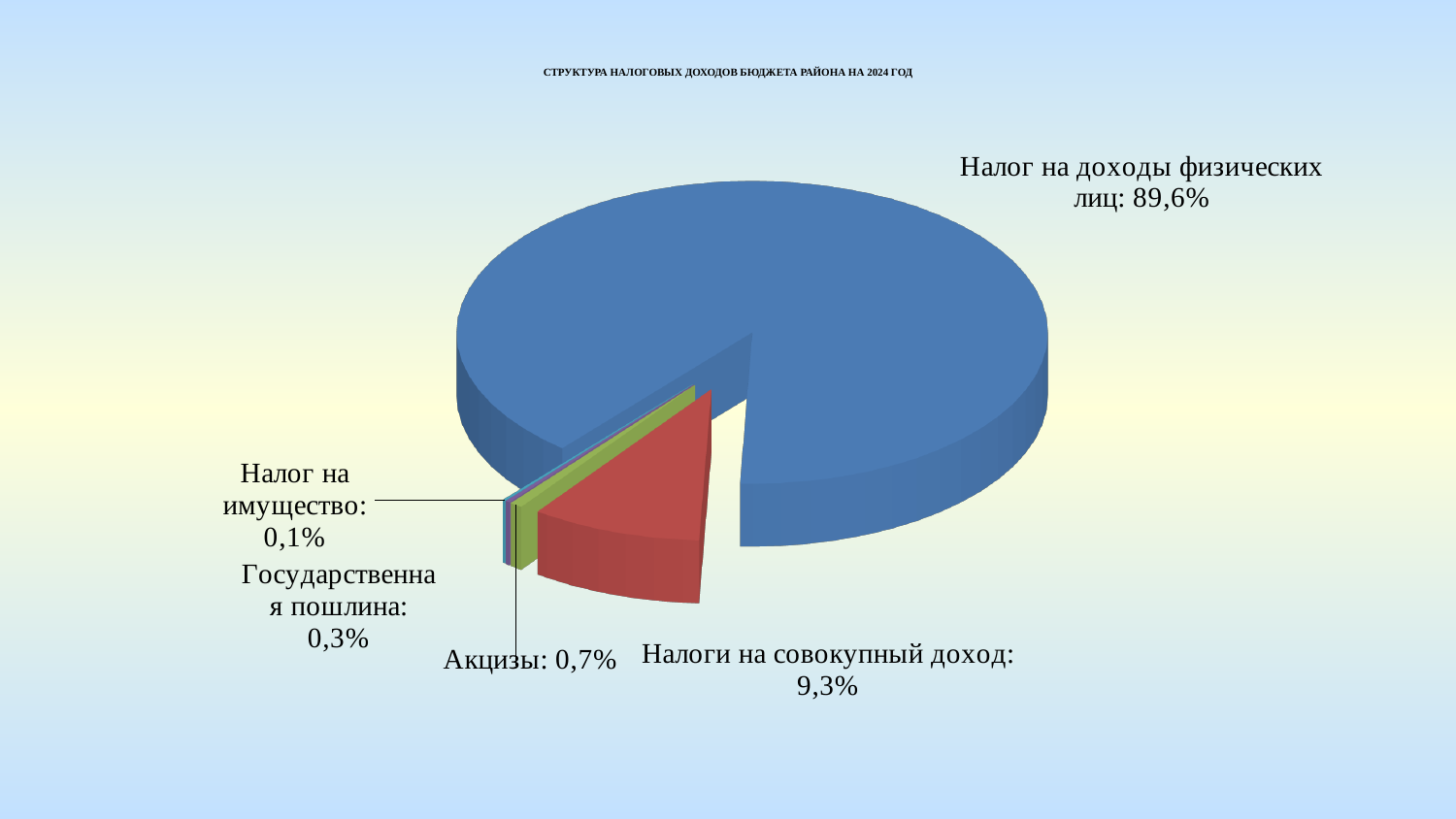
Which is larger: the value for "Акцизы" or the value for "Государственная пошлина"? Акцизы How many categories (slices) does the pie chart have? 5 What share of the pie does "Налог на доходы физических лиц" have? 89,6% What kind of chart is shown on the slide? Pie chart What is the difference between the values for "Налог на доходы физических лиц" and "Налоги на совокупный доход"? 80,3% Which category has the smallest slice of the pie? Налог на имущество What is the value shown for "Государственная пошлина"? 0,3% What is the value shown for "Акцизы"? 0,7% What is the value shown for "Налоги на совокупный доход"? 9,3% What is the value shown for "Налог на имущество"? 0,1% Which category has the largest slice of the pie? Налог на доходы физических лиц What is the title of the chart? СТРУКТУРА НАЛОГОВЫХ ДОХОДОВ БЮДЖЕТА РАЙОНА НА 2024 ГОД